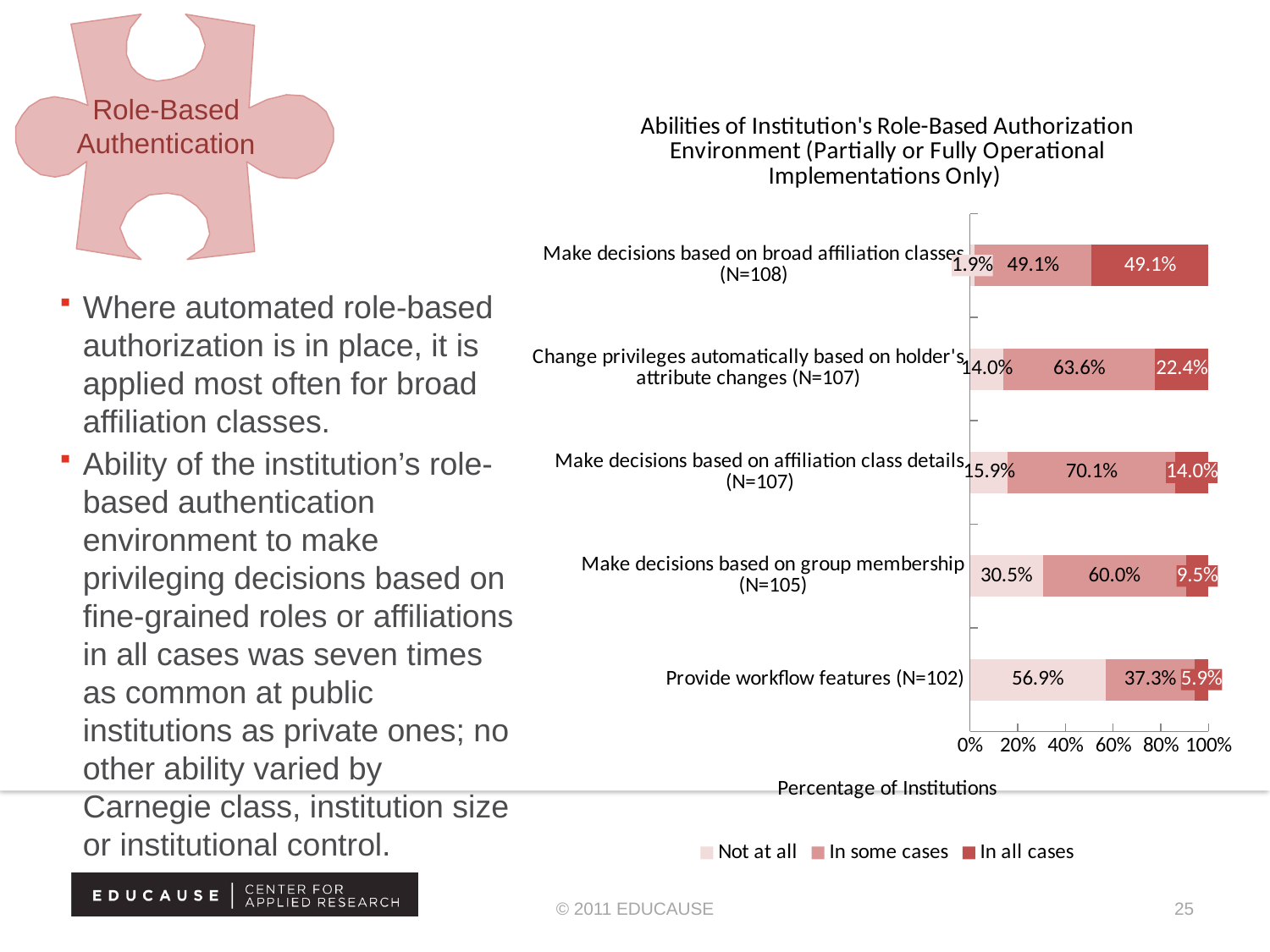
Which category has the lowest 'In all cases' percentage? Provide workflow features (N=102) How many series does the legend list? 3 What is the 'Not at all' value for 'Make decisions based on group membership (N=105)'? 30.5% Which is larger: the 'In all cases' value for 'Change privileges automatically based on holder's attribute changes (N=107)' or for 'Make decisions based on affiliation class details (N=107)'? Change privileges automatically based on holder's attribute changes (N=107) How many categories are shown in the chart? 5 What is the difference between the 'In some cases' values for 'Change privileges automatically based on holder's attribute changes (N=107)' and 'Make decisions based on group membership (N=105)'? 3.6% What is the 'Not at all' value for 'Provide workflow features (N=102)'? 56.9% What is the x-axis label of the chart? Percentage of Institutions What percentage of institutions reported 'In all cases' for 'Make decisions based on broad affiliation classes (N=108)'? 49.1% Which category has the highest 'Not at all' percentage? Provide workflow features (N=102) What is the 'In some cases' value for 'Make decisions based on affiliation class details (N=107)'? 70.1% What kind of chart is shown on the slide? Stacked bar chart